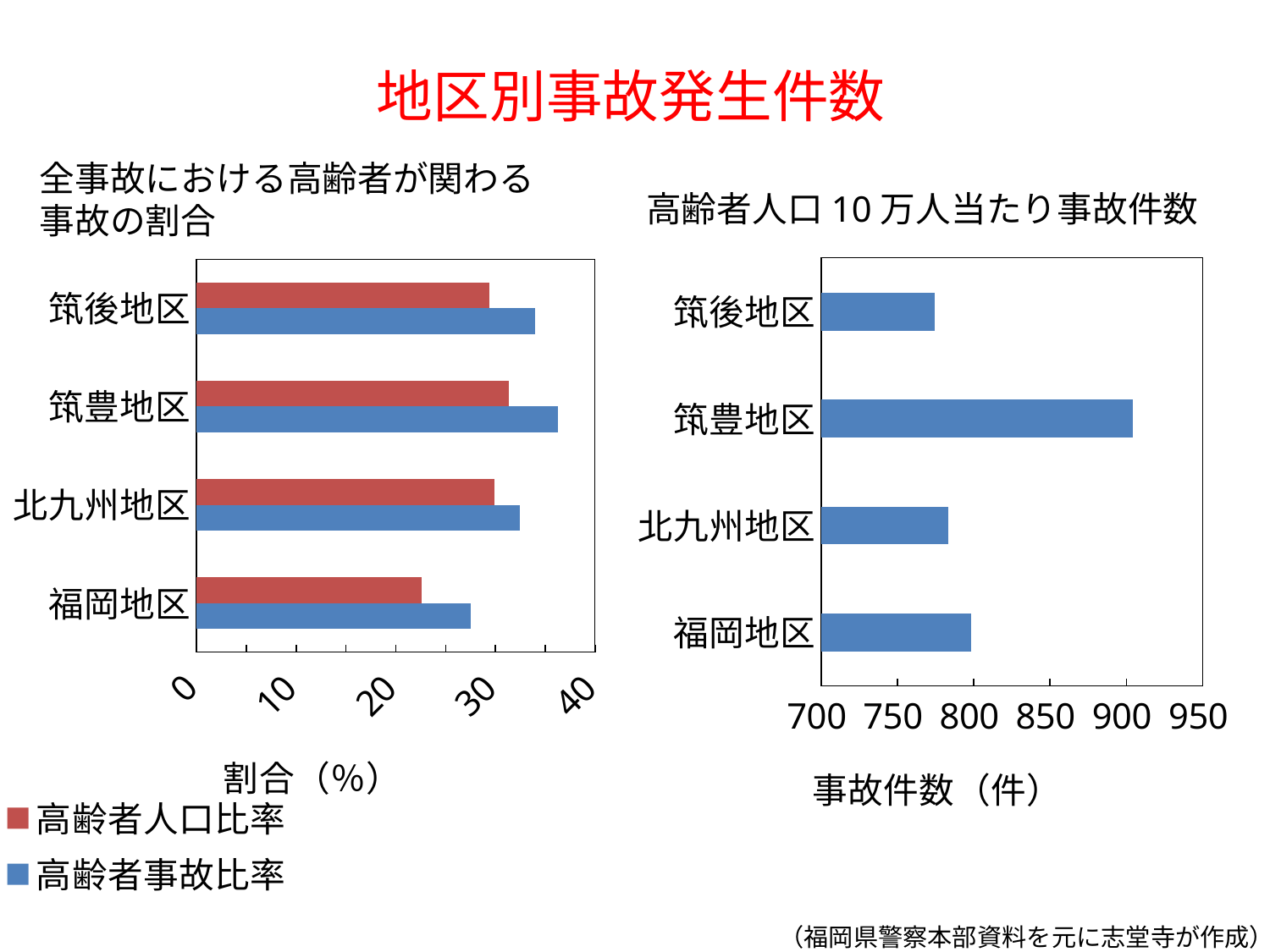
What kind of chart is the right chart (高齢者人口10万人当たり事故件数)? bar chart In the right chart (高齢者人口10万人当たり事故件数), which district has the highest number of accidents? 筑豊地区 How many districts are shown in the right chart (高齢者人口10万人当たり事故件数)? 4 How many series does the legend of the left chart (全事故における高齢者が関わる事故の割合) list? 2 In the left chart (全事故における高齢者が関わる事故の割合), is the 高齢者事故比率 for 筑豊地区 greater or less than 30? greater In the left chart (全事故における高齢者が関わる事故の割合), which district has the highest 高齢者事故比率? 筑豊地区 In the left chart (全事故における高齢者が関わる事故の割合), which district has the lowest 高齢者人口比率? 福岡地区 In the left chart (全事故における高齢者が関わる事故の割合), is the 高齢者人口比率 for 福岡地区 greater or less than 30? less In the right chart (高齢者人口10万人当たり事故件数), is the value for 筑豊地区 greater or less than 850? greater In the left chart (全事故における高齢者が関わる事故の割合), for 福岡地区, which is larger: 高齢者人口比率 or 高齢者事故比率? 高齢者事故比率